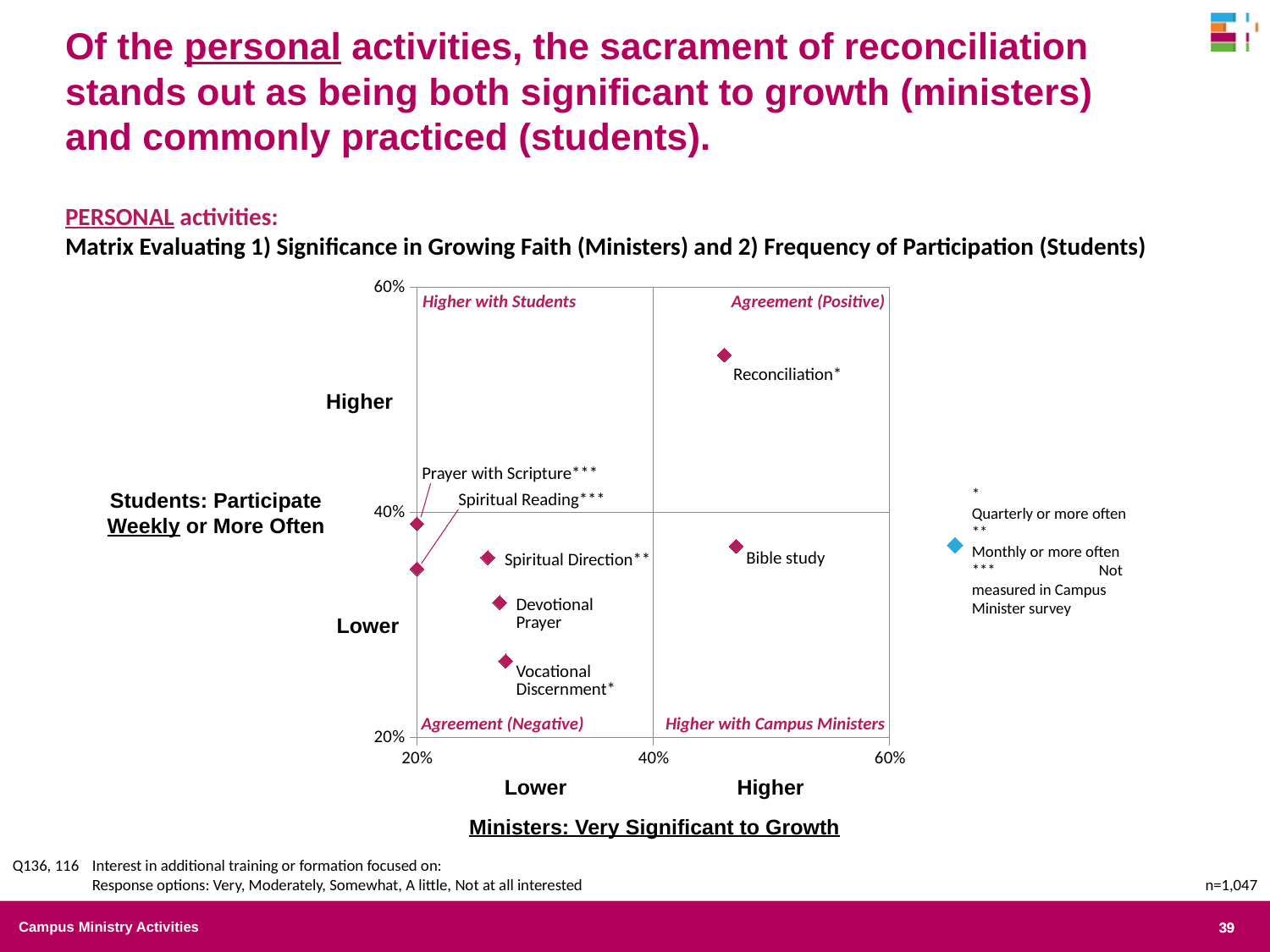
Which activity has the highest value on the horizontal axis (Ministers: Very Significant to Growth)? Bible study Is the vertical-axis value for Reconciliation* greater or less than 40%? greater What kind of chart is shown on the slide? Scatter plot How many activities are plotted as points on the chart? 7 Is the vertical-axis value for Bible study greater or less than 40%? less Which has the higher vertical-axis value, Devotional Prayer or Vocational Discernment*? Devotional Prayer Which activity has the lowest value on the vertical axis (Students: Participate Weekly or More Often)? Vocational Discernment* Is the horizontal-axis value for Spiritual Direction** greater or less than 40%? less Which activity has the highest value on the vertical axis (Students: Participate Weekly or More Often)? Reconciliation* In which labelled quadrant of the chart does Reconciliation* appear? Agreement (Positive) In which labelled quadrant of the chart does Bible study appear? Higher with Campus Ministers